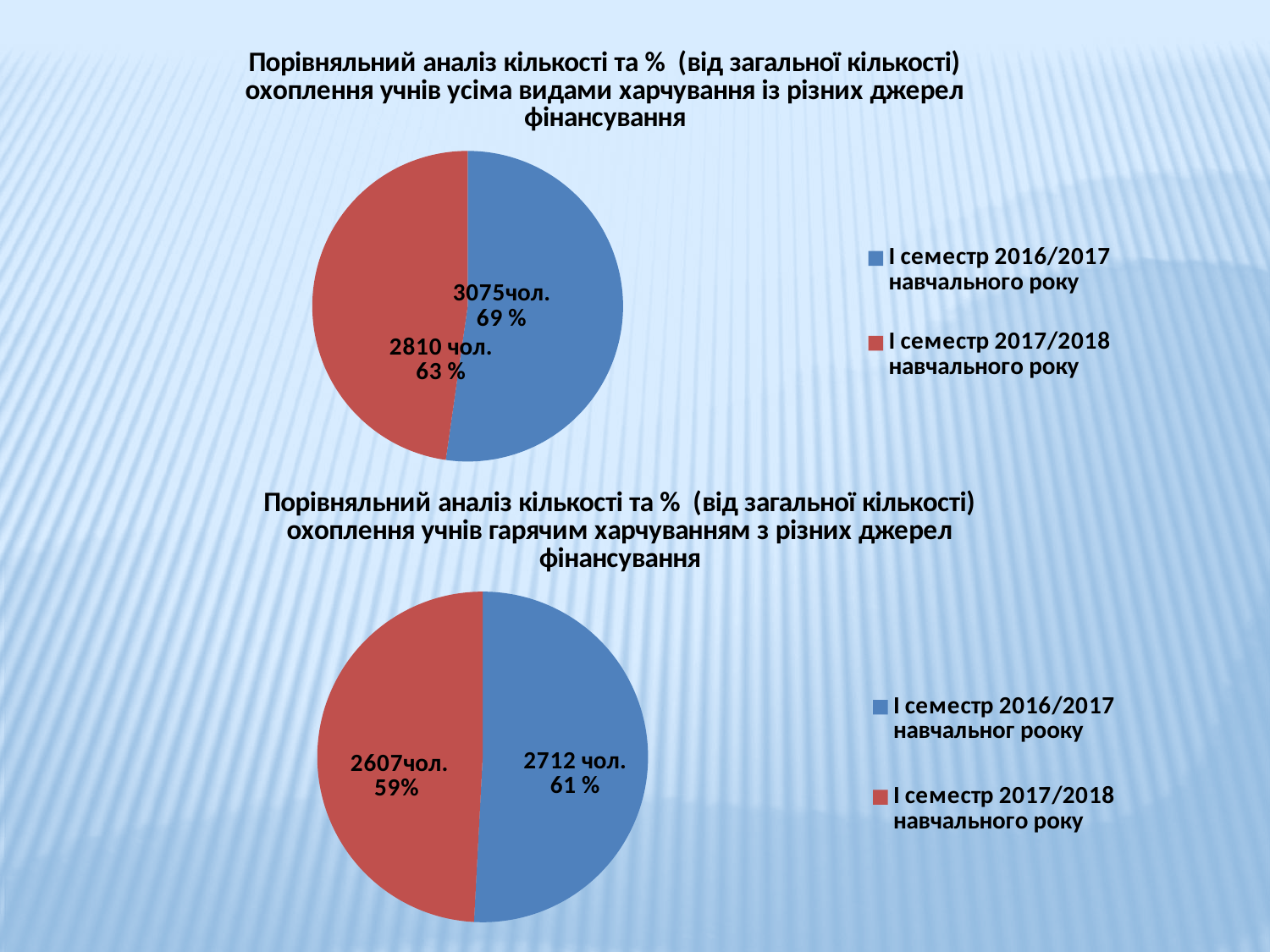
On the top chart, which colour represents I семестр 2017/2018 навчального року? red What type of chart is the top chart? pie chart Is the number of students for I семестр 2016/2017 larger on the top chart or on the bottom chart? top chart On the bottom chart, how many students does the I семестр 2017/2018 slice show? 2607чол. On the top chart, what is the difference in students between I семестр 2016/2017 and I семестр 2017/2018? 265 On the bottom chart, which semester has the smaller number of students? I семестр 2017/2018 навчального року On the top chart, which semester has the larger number of students? I семестр 2016/2017 навчального року On the bottom chart, what is the difference in students between I семестр 2016/2017 and I семестр 2017/2018? 105 How many slices does the bottom chart have? 2 On the top chart, how many students does the I семестр 2016/2017 slice show? 3075чол. On the top chart, what percentage is printed on the I семестр 2017/2018 slice? 63 % On the bottom chart, what percentage is printed on the I семестр 2016/2017 slice? 61 %